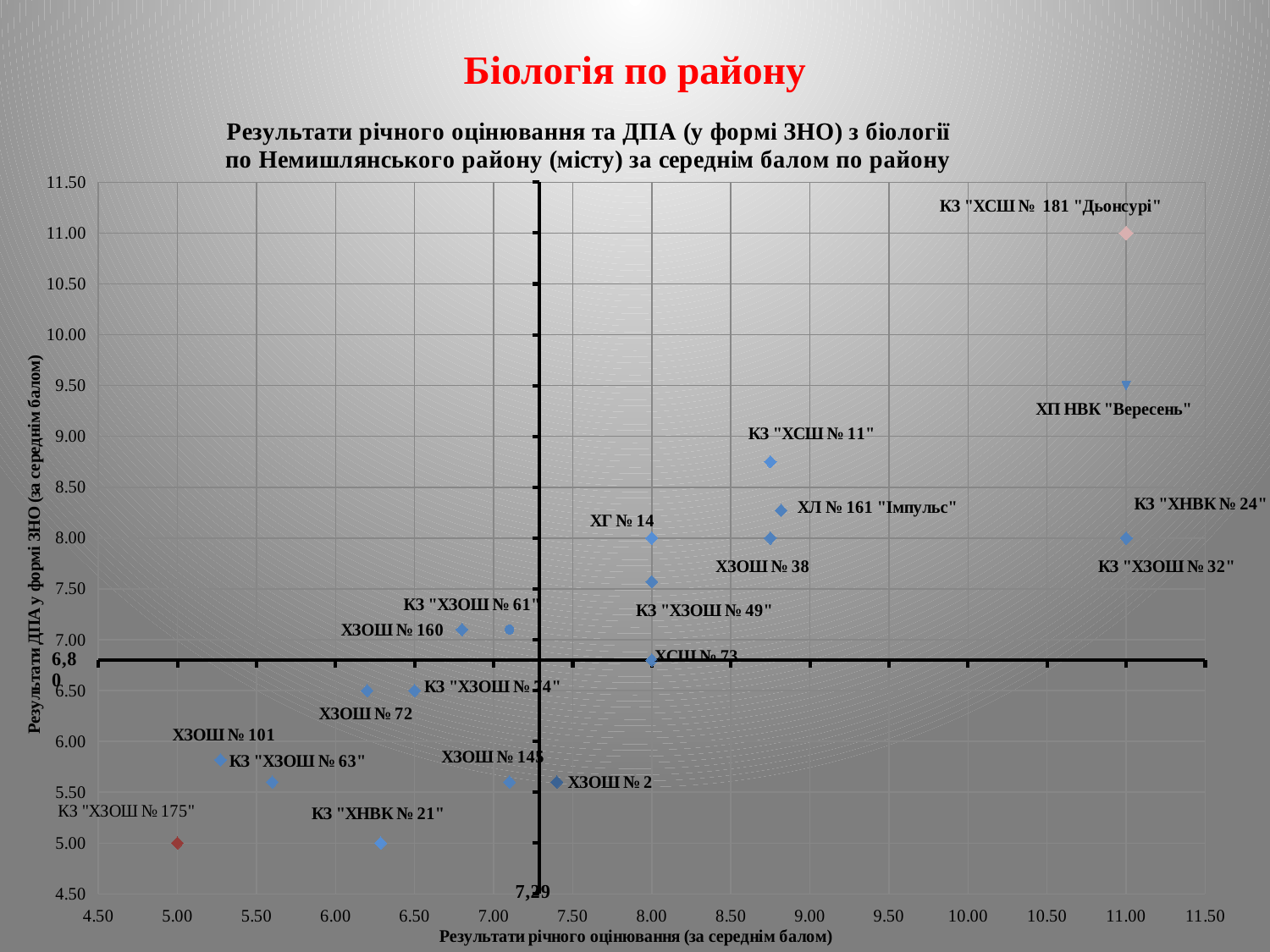
What is the ДПА result for КЗ "ХСШ № 181 "Дьонсурі"? 11.00 What is the ДПА result for ХП НВК "Вересень"? 9.50 What is the annual assessment score for КЗ "ХЗОШ № 175"? 5.00 Is the ДПА result for ХЗОШ № 2 greater or less than 6.00? less What kind of chart is shown on the slide? scatter chart What district average value is marked on the horizontal (annual assessment) axis crosshair line? 7,29 Which school has the lowest annual assessment score (x axis) on the chart? КЗ "ХЗОШ № 175" Is the ДПА result for КЗ "ХСШ № 11" greater or less than 8.50? greater Which school has the highest ДПА (ЗНО) result on the chart? КЗ "ХСШ № 181 "Дьонсурі" What district average value is marked on the vertical (ДПА) axis crosshair line? 6,80 Which has the higher ДПА result: КЗ "ХСШ № 181 "Дьонсурі" or ХП НВК "Вересень"? КЗ "ХСШ № 181 "Дьонсурі" Is the annual assessment score for ХЗОШ № 72 greater or less than 6.50? less